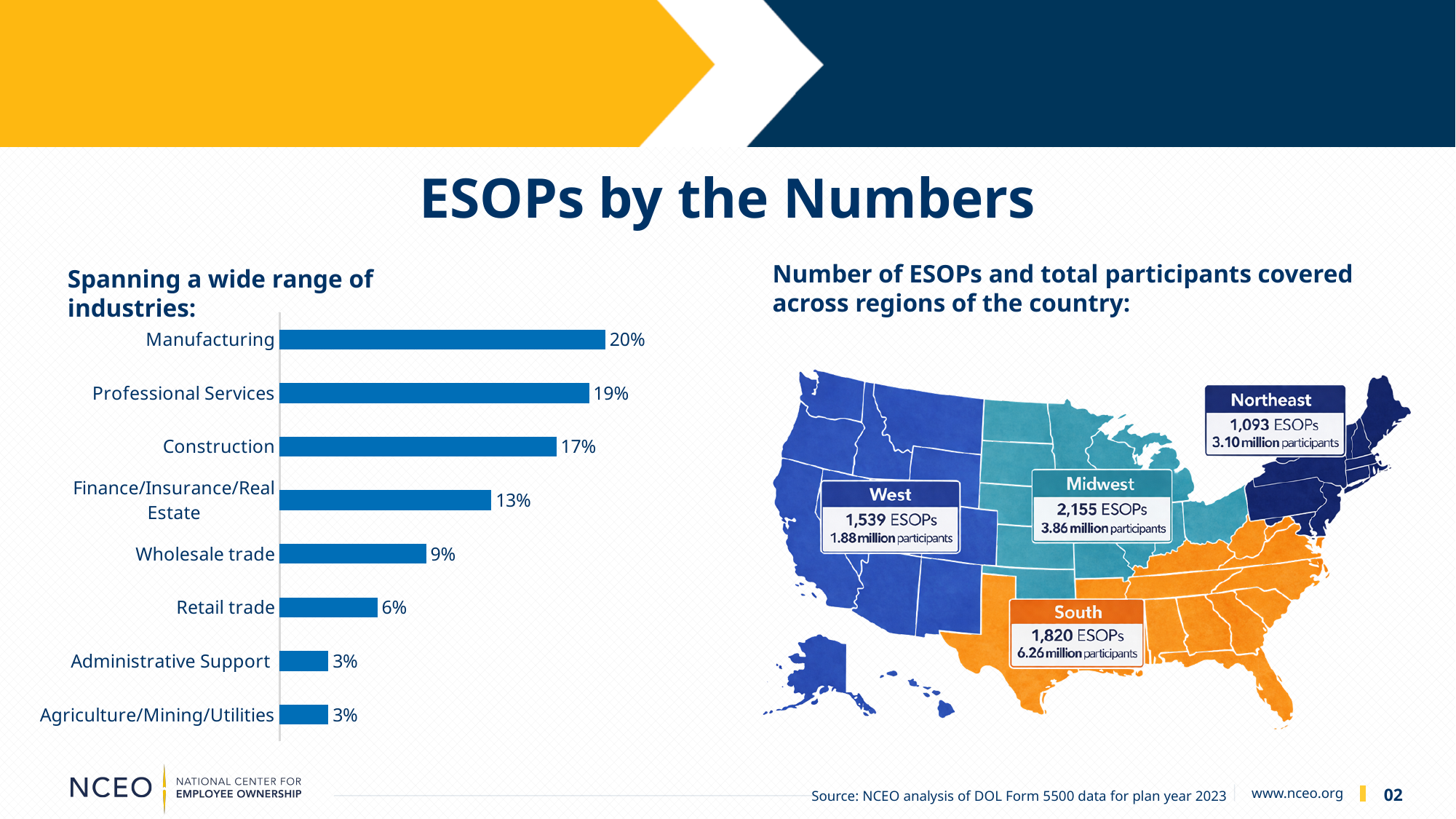
In the industries bar chart, do the values rise or fall going from the top bar to the bottom bar? fall In the industries bar chart, what is the difference between Manufacturing and Professional Services? 1% What kind of chart is shown under 'Spanning a wide range of industries'? bar chart In the industries bar chart, what is the value for Manufacturing? 20% In the industries bar chart, what is the difference between Construction and Wholesale trade? 8% On the regional map, how many ESOPs are in the Midwest? 2,155 ESOPs In the industries bar chart, what is the value for Finance/Insurance/Real Estate? 13% In the industries bar chart, what is the value for Retail trade? 6% In the industries bar chart, what is the value for Construction? 17% In the industries bar chart, which industry has the highest value? Manufacturing In the industries bar chart, how many industry categories are shown? 8 In the industries bar chart, which is larger, Wholesale trade or Retail trade? Wholesale trade